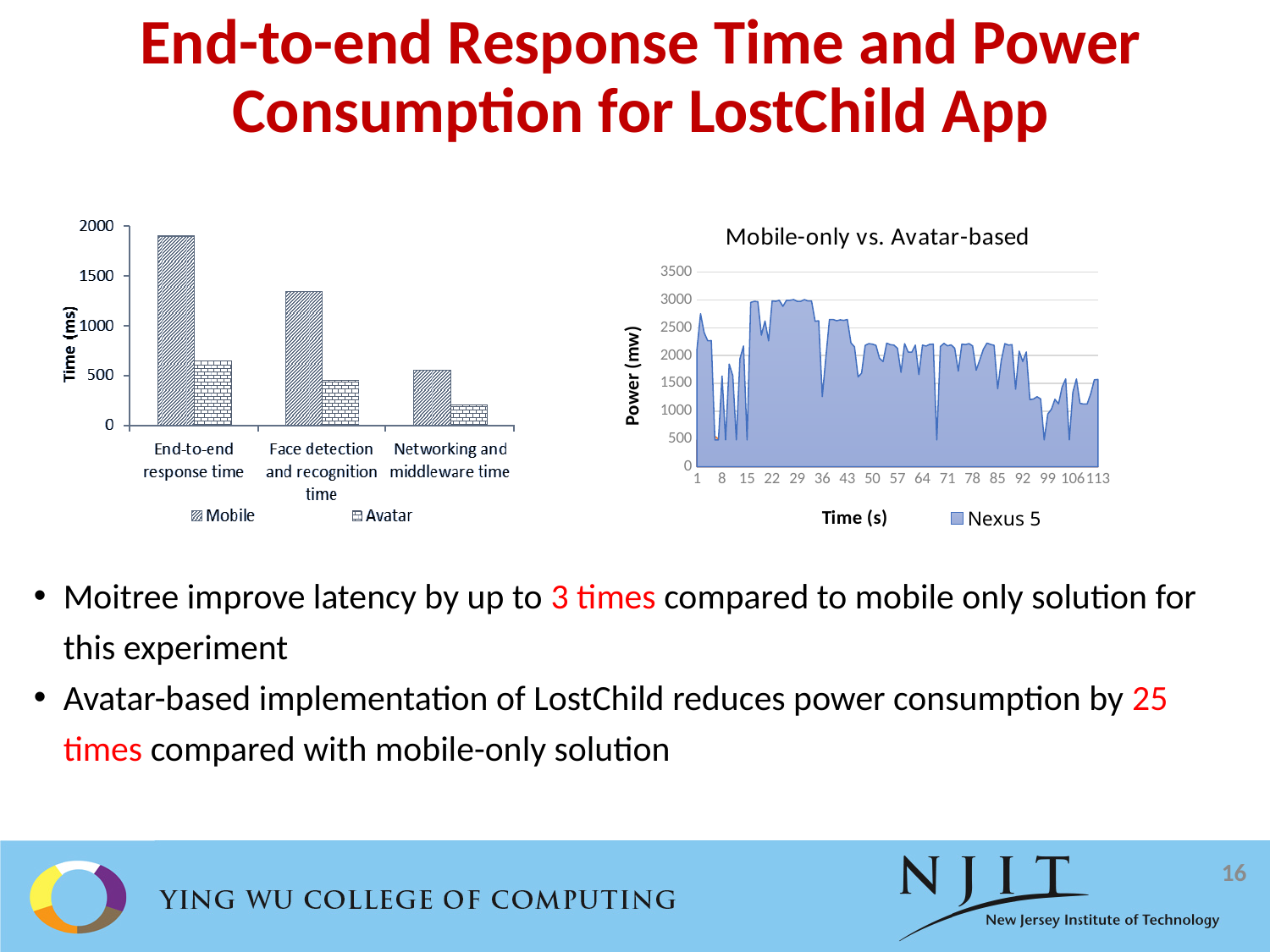
On the left chart, which category has the highest Mobile value? End-to-end response time On the chart titled 'Mobile-only vs. Avatar-based', what series does the legend list? Nexus 5 On the left chart, which category has the lowest Avatar value? Networking and middleware time On the left chart, is the Avatar value for Networking and middleware time greater or less than 500? less What is the title of the chart on the right? Mobile-only vs. Avatar-based On the left chart, is the Avatar value for Face detection and recognition time greater or less than 500? less On the left chart, is the Mobile value for Face detection and recognition time greater or less than 1000? greater On the left chart, how many series does the legend list? 2 On the left chart, which series has the larger value for End-to-end response time, Mobile or Avatar? Mobile On the left chart, how many categories are shown on the x axis? 3 On the left chart, what type of chart is shown? bar chart